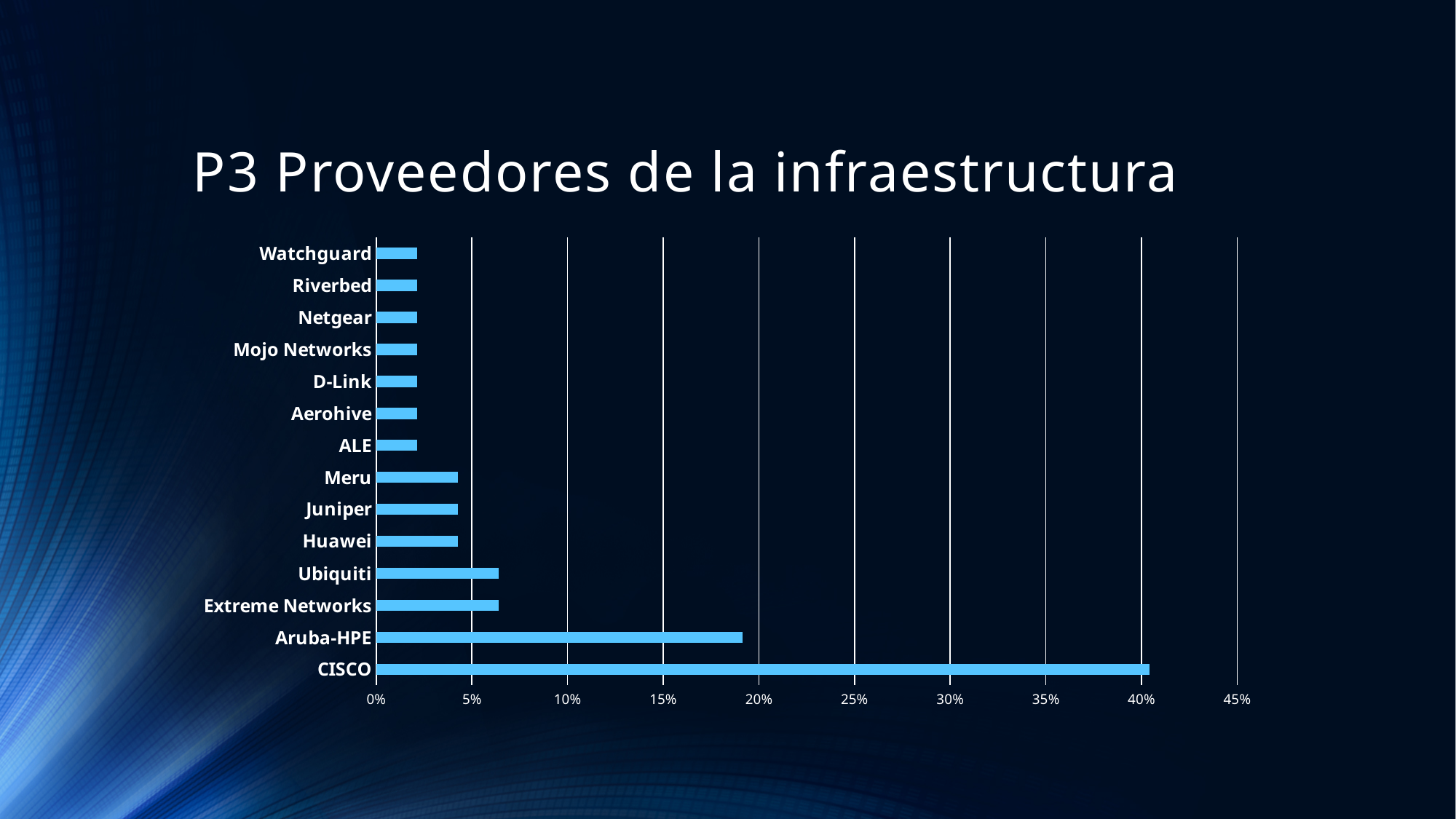
Is the value for Aruba-HPE greater or less than 15%? greater What is the title of the slide containing the chart? P3 Proveedores de la infraestructura Which has a larger value, CISCO or Aruba-HPE? CISCO Which provider has the highest value in the chart? CISCO How many providers (categories) are listed in the chart? 14 Is the value for CISCO greater or less than 35%? greater Is the value for Extreme Networks greater or less than 5%? greater Which has a larger value, Ubiquiti or Huawei? Ubiquiti What kind of chart is shown on the slide? bar chart